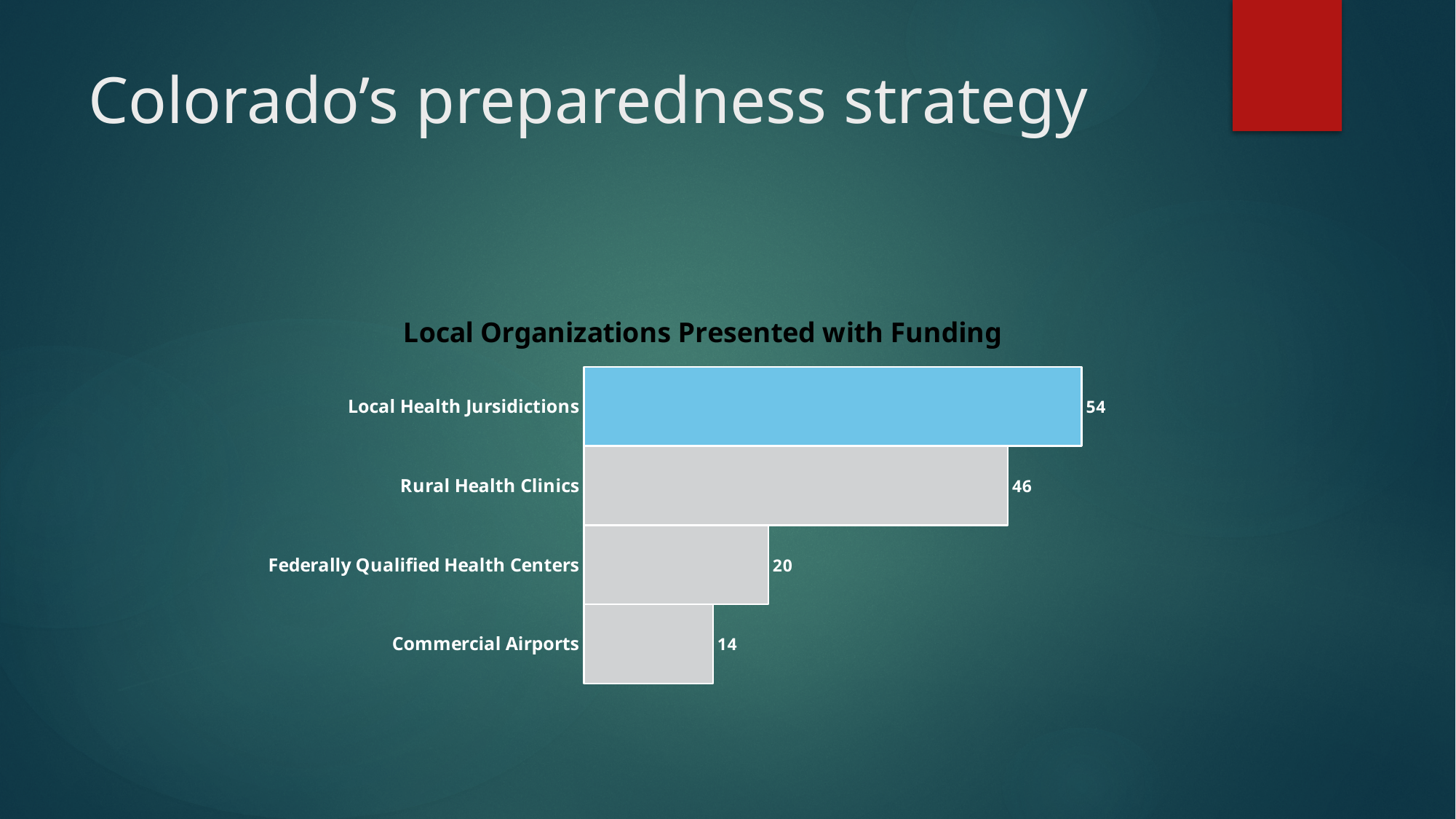
Which is larger, the value for Rural Health Clinics or the value for Federally Qualified Health Centers? Rural Health Clinics What is the value for Local Health Jursidictions? 54 What kind of chart is shown on the slide? Bar chart What is the difference between the values for Local Health Jursidictions and Rural Health Clinics? 8 Which category has the lowest value? Commercial Airports What is the title of the chart? Local Organizations Presented with Funding How many categories are shown in the chart? 4 Which category has the highest value? Local Health Jursidictions What is the value for Rural Health Clinics? 46 What is the value for Commercial Airports? 14 What is the difference between the values for Federally Qualified Health Centers and Commercial Airports? 6 What is the value for Federally Qualified Health Centers? 20